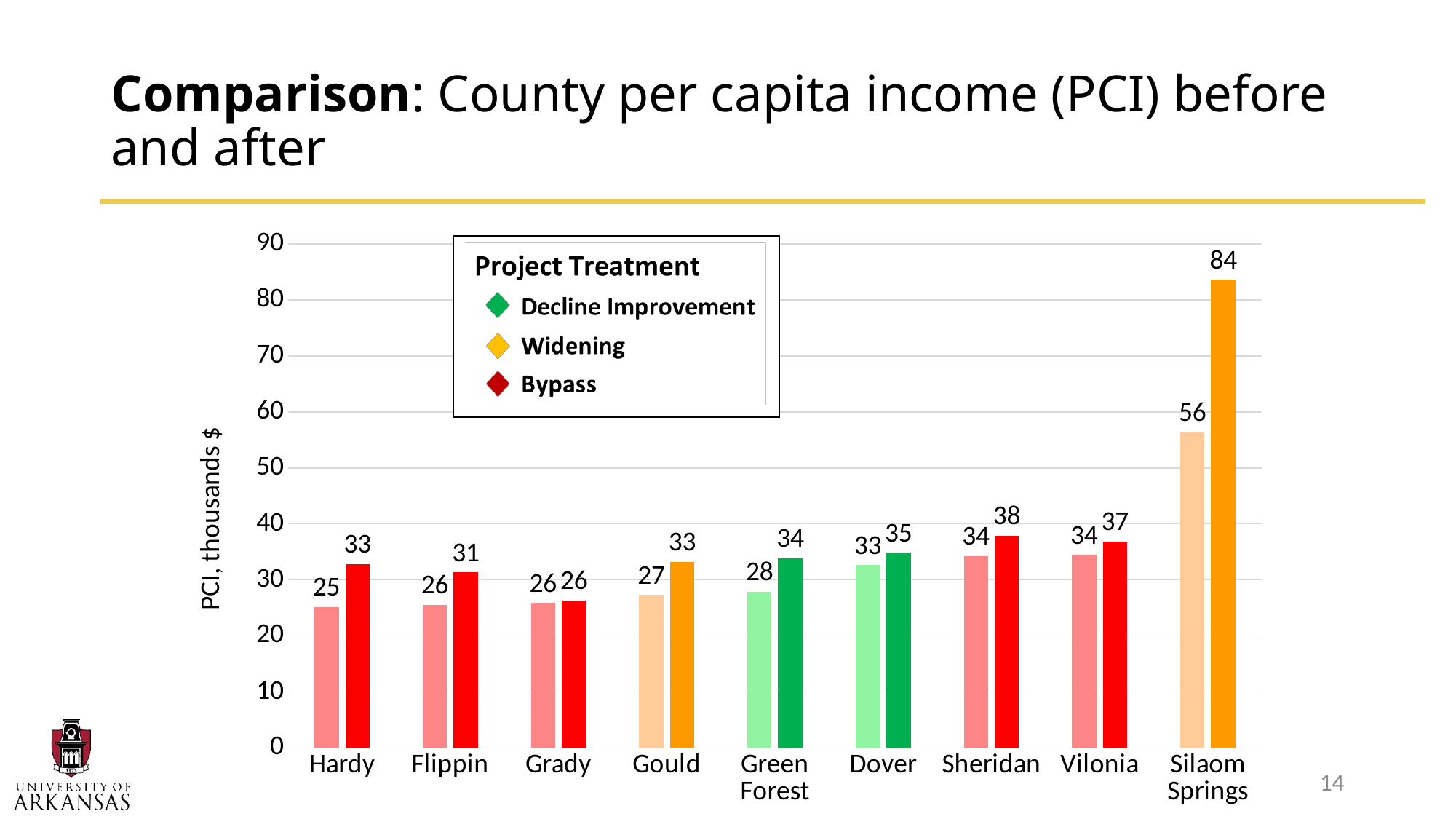
Which project treatment is shown in green in the legend? Decline Improvement How many project treatments does the legend list? 3 What is the 'after' PCI value for Sheridan? 38 What is the difference between the 'after' and 'before' PCI values for Hardy? 8 What is the difference between the 'after' and 'before' PCI values for Silaom Springs? 28 Which project location has the highest 'after' PCI value? Silaom Springs Is the 'after' PCI value for Flippin larger or smaller than the 'after' PCI value for Sheridan? smaller What kind of chart is shown on the slide? bar chart What is the 'before' PCI value for Hardy? 25 What is the 'after' PCI value for Silaom Springs? 84 How many project locations are shown on the x axis? 9 Which project location has the lowest 'before' PCI value? Hardy